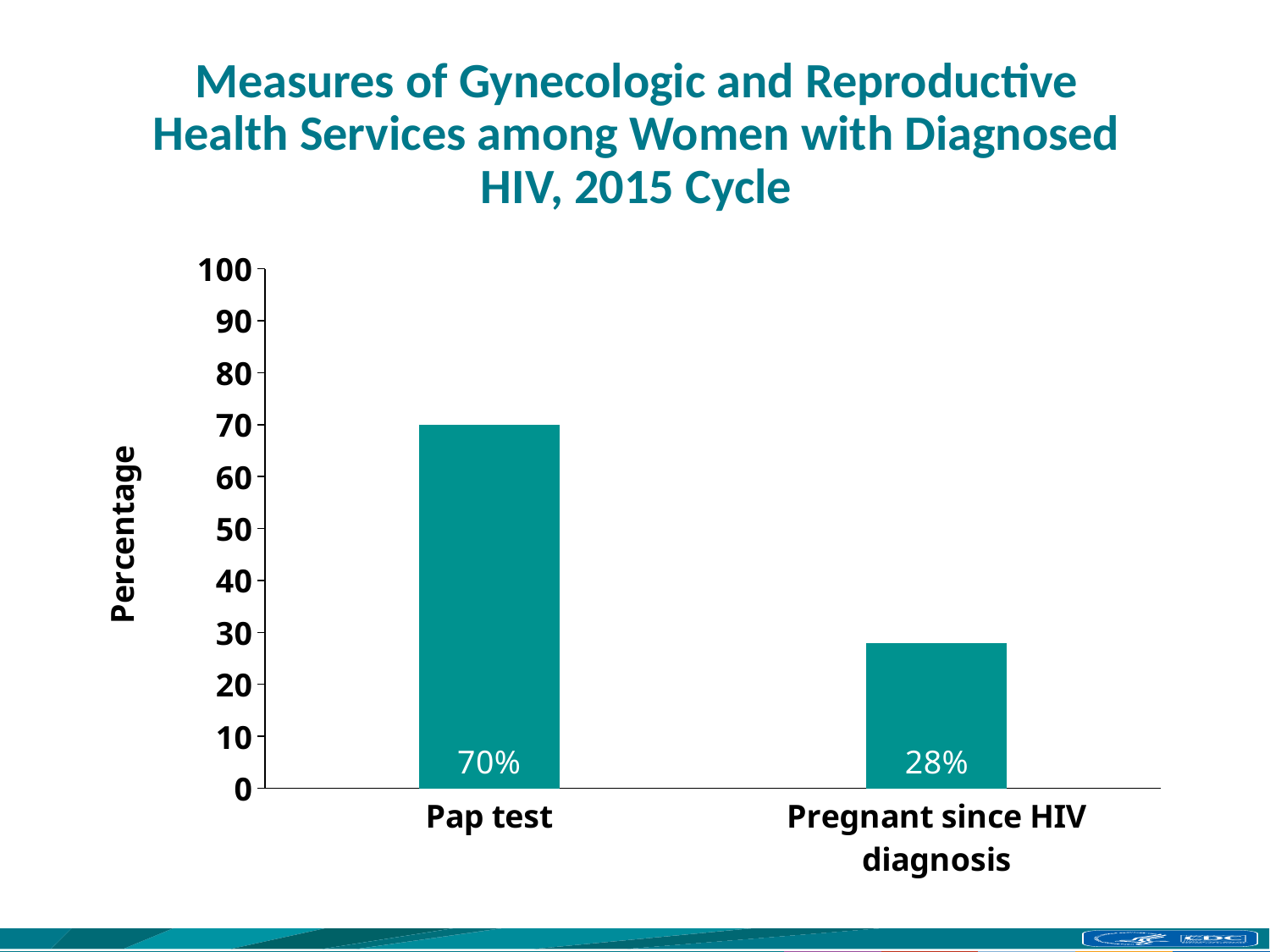
Is the value for Pregnant since HIV diagnosis greater or less than 30? less What is the label of the vertical axis? Percentage What percentage of women with diagnosed HIV had a Pap test? 70% Is the value for Pap test greater or less than 60? greater What percentage of women with diagnosed HIV had been pregnant since HIV diagnosis? 28% Which category has the highest value? Pap test How many categories are shown on the chart? 2 What is the difference in percentage points between Pap test and Pregnant since HIV diagnosis? 42 Which category has the lowest value? Pregnant since HIV diagnosis What kind of chart is shown on the slide? bar chart What is the maximum value shown on the vertical axis? 100 Which is larger, the value for Pap test or the value for Pregnant since HIV diagnosis? Pap test